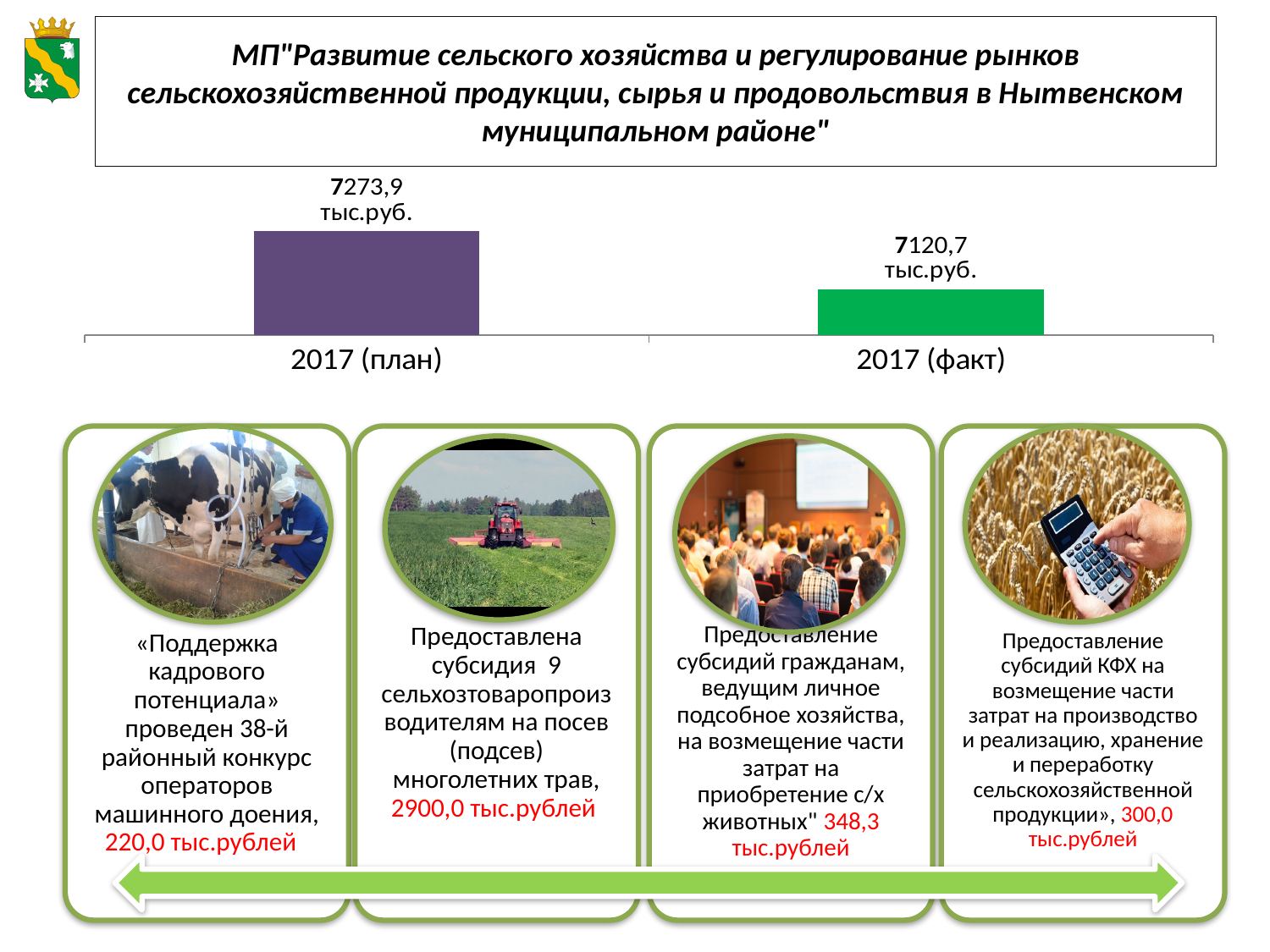
What kind of chart is shown on the slide? Bar chart What colour is the bar for 2017 (факт)? Green What colour is the bar for 2017 (план)? Purple What is the value for 2017 (план)? 7273,9 тыс.руб. Which category has the higher value, 2017 (план) or 2017 (факт)? 2017 (план) What is the difference between the 2017 (план) and 2017 (факт) values? 153,2 тыс.руб. How many categories are shown in the chart? 2 What is the value for 2017 (факт)? 7120,7 тыс.руб. Is the value for 2017 (факт) larger than the value for 2017 (план)? No Do the values rise or fall from 2017 (план) to 2017 (факт)? Fall Which category has the lowest value? 2017 (факт)